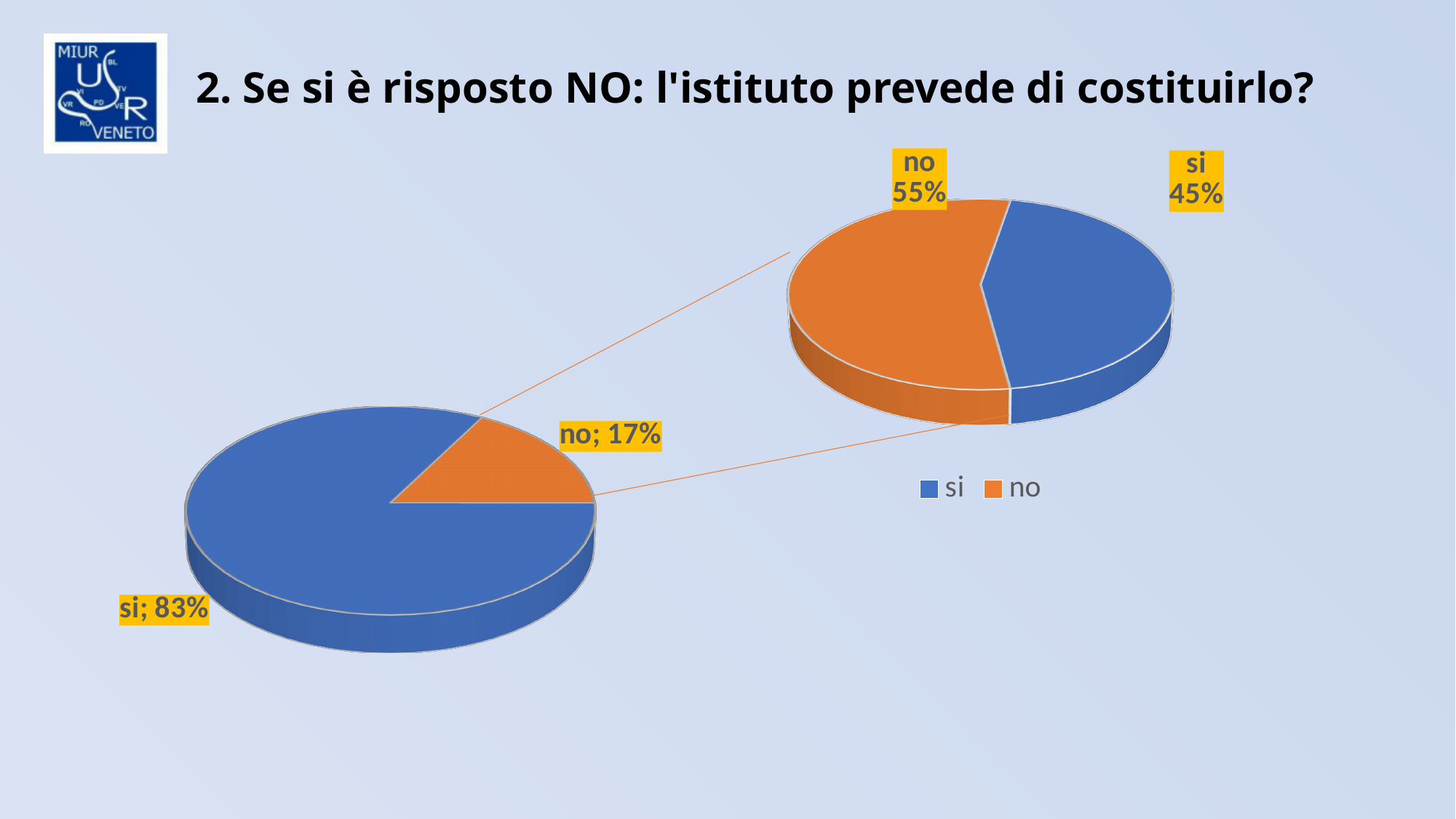
How many slices does the large pie chart at the bottom left have? 2 In the large pie chart at the bottom left, what share is labelled "si"? 83% In the smaller pie chart at the top right, which slice is the largest? no In the smaller pie chart at the top right, what share is labelled "no"? 55% In the large pie chart at the bottom left, which slice is the largest? si In the large pie chart at the bottom left, what is the difference in percentage points between the "si" and "no" slices? 66 Which colour represents "no" in the legend? orange In the smaller pie chart at the top right, what share is labelled "si"? 45% What kind of chart is shown on the slide? pie chart In the smaller pie chart at the top right, what is the difference in percentage points between the "no" and "si" slices? 10 How many entries does the legend list? 2